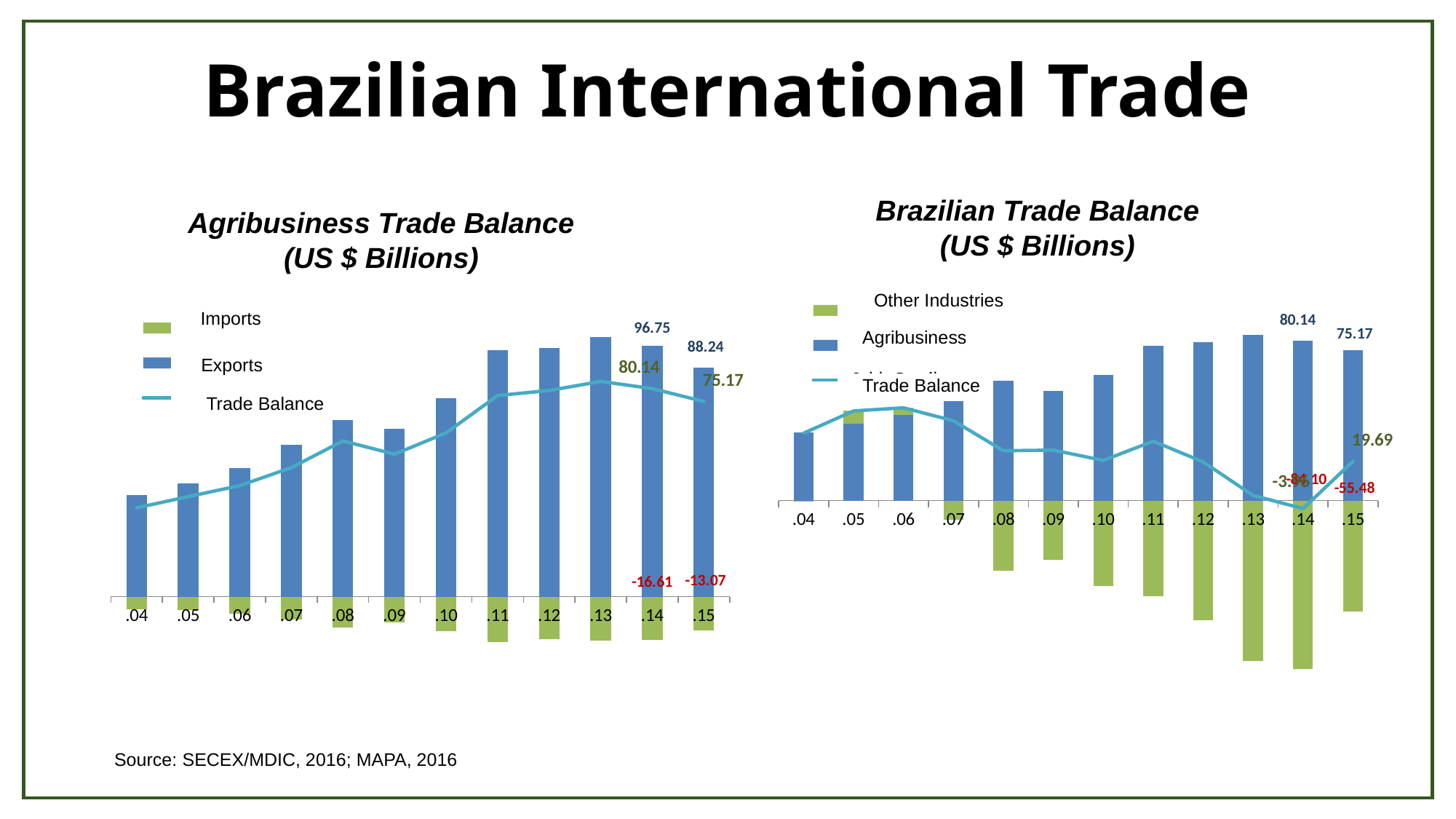
In the Agribusiness Trade Balance chart, how many series does the legend list? 3 In the Agribusiness Trade Balance chart, what is the Exports value for .15? 88.24 In the Agribusiness Trade Balance chart, what is the Trade Balance value for .15? 75.17 In the Agribusiness Trade Balance chart, does the Trade Balance line rise or fall from .04 to .13? rise In the Brazilian Trade Balance chart, what is the Trade Balance value for .15? 19.69 In the Agribusiness Trade Balance chart, how many years are shown on the x axis? 12 In the Agribusiness Trade Balance chart, which year has the lowest Exports bar? .04 In the Agribusiness Trade Balance chart, what is the difference between the Exports values for .14 and .15? 8.51 In the Brazilian Trade Balance chart, which year has the lowest point on the Trade Balance line? .14 In the Agribusiness Trade Balance chart, what is the Imports value for .14? -16.61 In the Brazilian Trade Balance chart, what is the Other Industries value for .15? -55.48 What kind of chart is the Brazilian Trade Balance chart? bar chart with a line